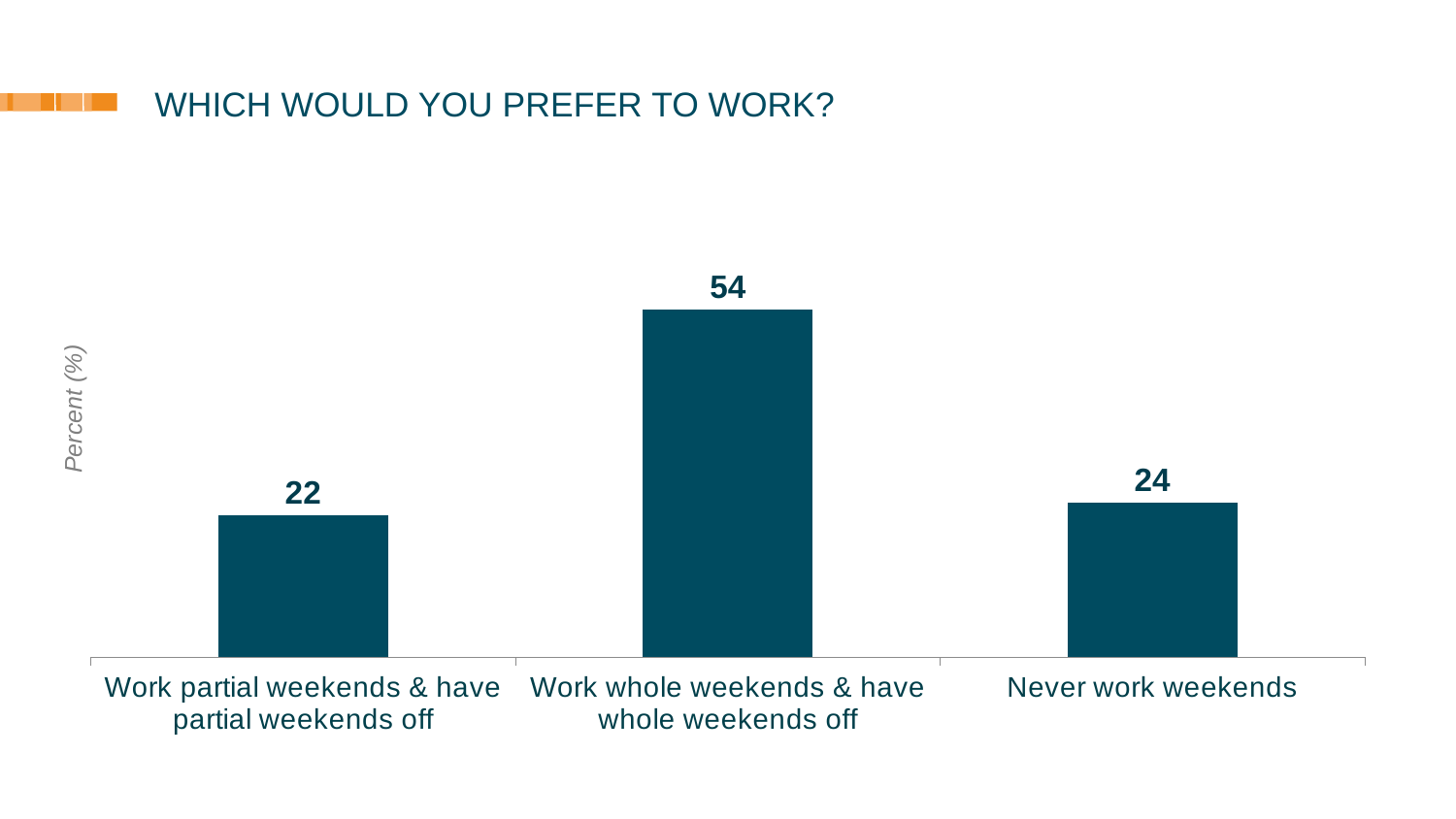
What is the label on the vertical axis? Percent (%) What is the value for "Never work weekends"? 24 What is the difference between the values for "Work whole weekends & have whole weekends off" and "Never work weekends"? 30 Which category has the lowest value? Work partial weekends & have partial weekends off What is the value for "Work partial weekends & have partial weekends off"? 22 What is the title of the chart? WHICH WOULD YOU PREFER TO WORK? What kind of chart is shown on the slide? Bar chart How many categories are shown in the chart? 3 What is the value for "Work whole weekends & have whole weekends off"? 54 Which is larger: the value for "Work whole weekends & have whole weekends off" or the value for "Work partial weekends & have partial weekends off"? Work whole weekends & have whole weekends off Which category has the highest value? Work whole weekends & have whole weekends off What is the difference between the values for "Never work weekends" and "Work partial weekends & have partial weekends off"? 2